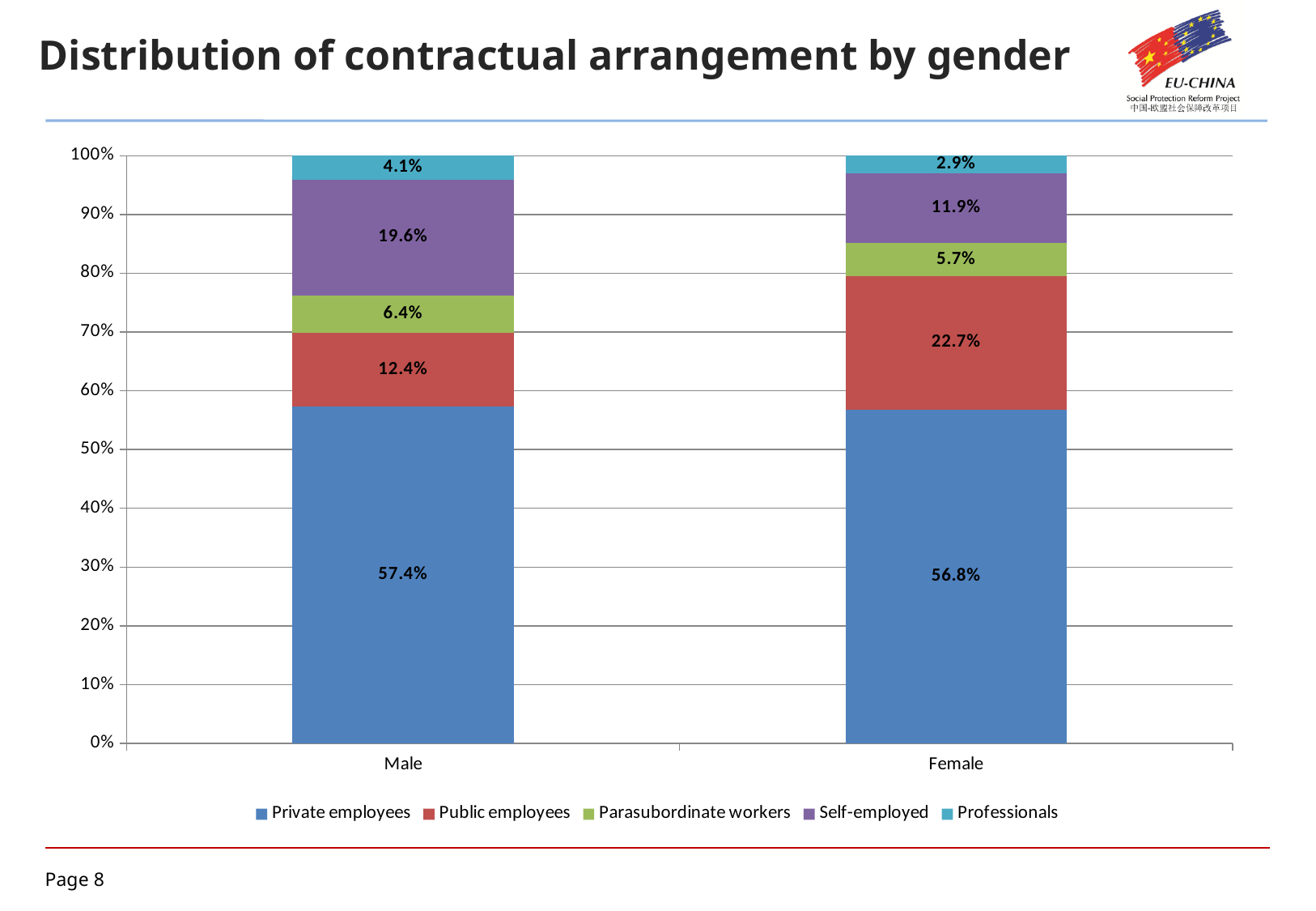
What is the professionals share for females? 2.9% What percentage of females are public employees? 22.7% How many series does the legend list? 5 Which gender has the larger share of self-employed? Male What kind of chart is shown on the slide? Stacked bar chart What percentage of males are private employees? 57.4% What is the parasubordinate workers share for females? 5.7% Which gender has the larger share of public employees? Female What is the difference between the male and female self-employed shares? 7.7% What is the difference between the female and male public employee shares? 10.3% How many categories are shown on the x axis? 2 What is the self-employed share for males? 19.6%